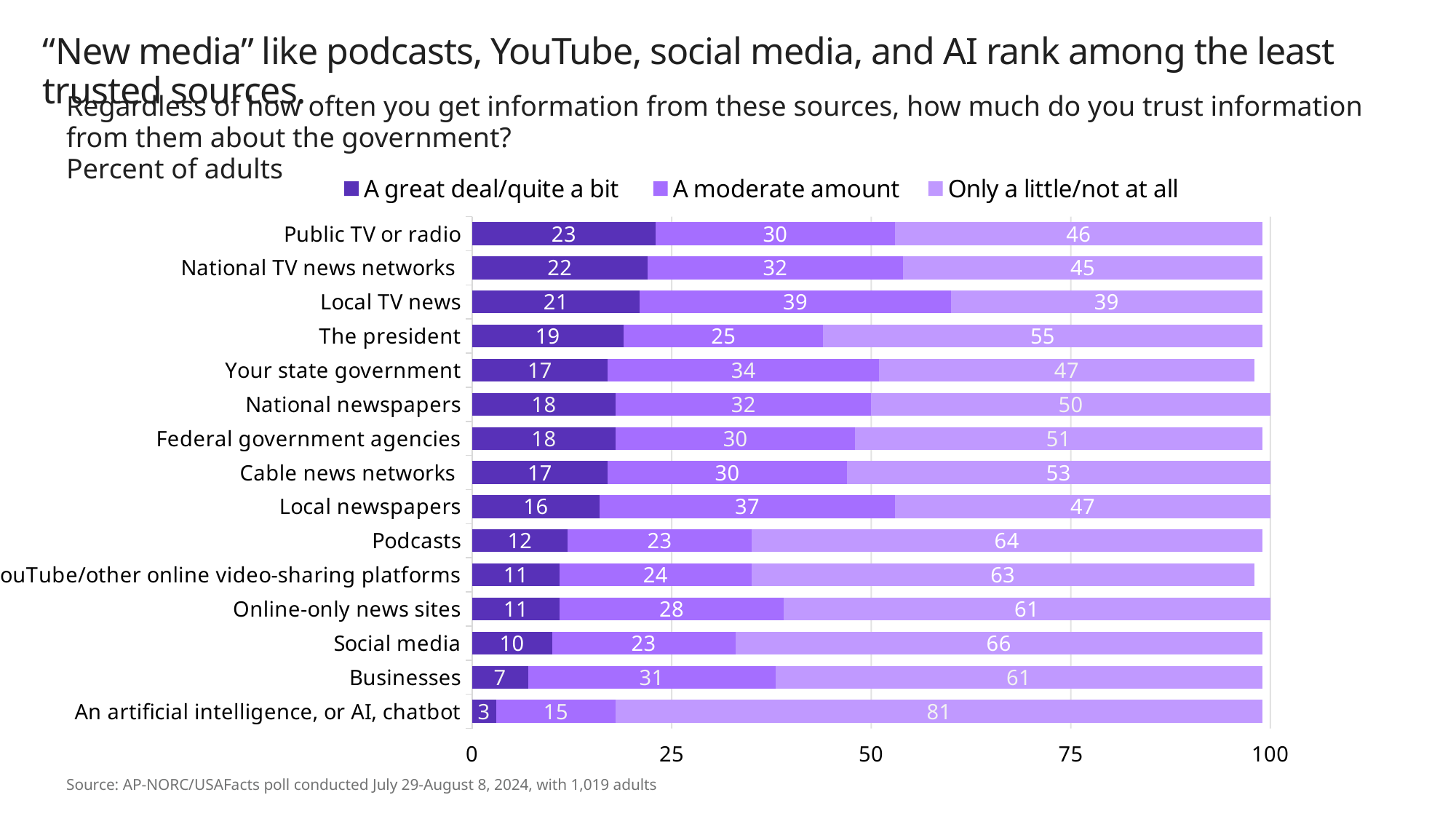
How many sources are listed on the chart? 15 What is the total of the three segments for the Social media bar? 99 Which source has the highest "A great deal/quite a bit" value? Public TV or radio Which source has the highest "A moderate amount" value? Local TV news What is the "Only a little/not at all" value for An artificial intelligence, or AI, chatbot? 81 How many series does the legend list? 3 Which source has the lowest "A great deal/quite a bit" value? An artificial intelligence, or AI, chatbot What is the "A moderate amount" value for Local newspapers? 37 What is the difference between the "Only a little/not at all" values for An artificial intelligence, or AI, chatbot and Social media? 15 Which has a larger "A moderate amount" value, Local TV news or The president? Local TV news What kind of chart is shown on the slide? Stacked bar chart What percent of adults trust Public TV or radio "A great deal/quite a bit"? 23